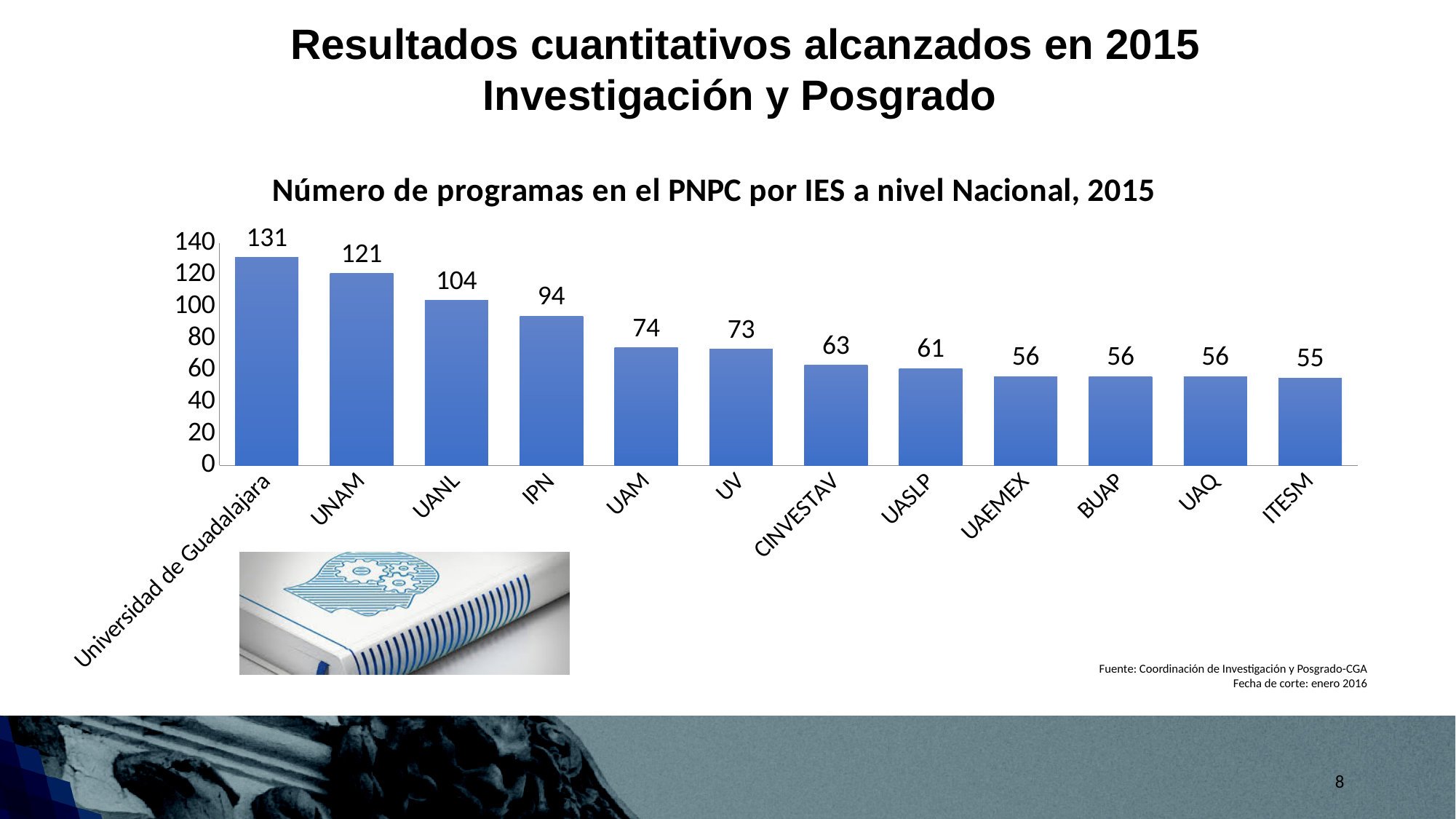
What kind of chart is shown on the slide? Bar chart What is the difference between the values for UANL and IPN? 10 Is the value for IPN greater or less than 100? less How many PNPC programs does Universidad de Guadalajara have? 131 What is the value shown for UNAM? 121 Which institution has the lowest number of PNPC programs? ITESM What is the value shown for CINVESTAV? 63 What is the title of the chart? Número de programas en el PNPC por IES a nivel Nacional, 2015 How many institutions are shown on the chart? 12 What is the difference between the values for Universidad de Guadalajara and UNAM? 10 Which institution has the highest number of PNPC programs? Universidad de Guadalajara Which has a larger value, UAM or UASLP? UAM